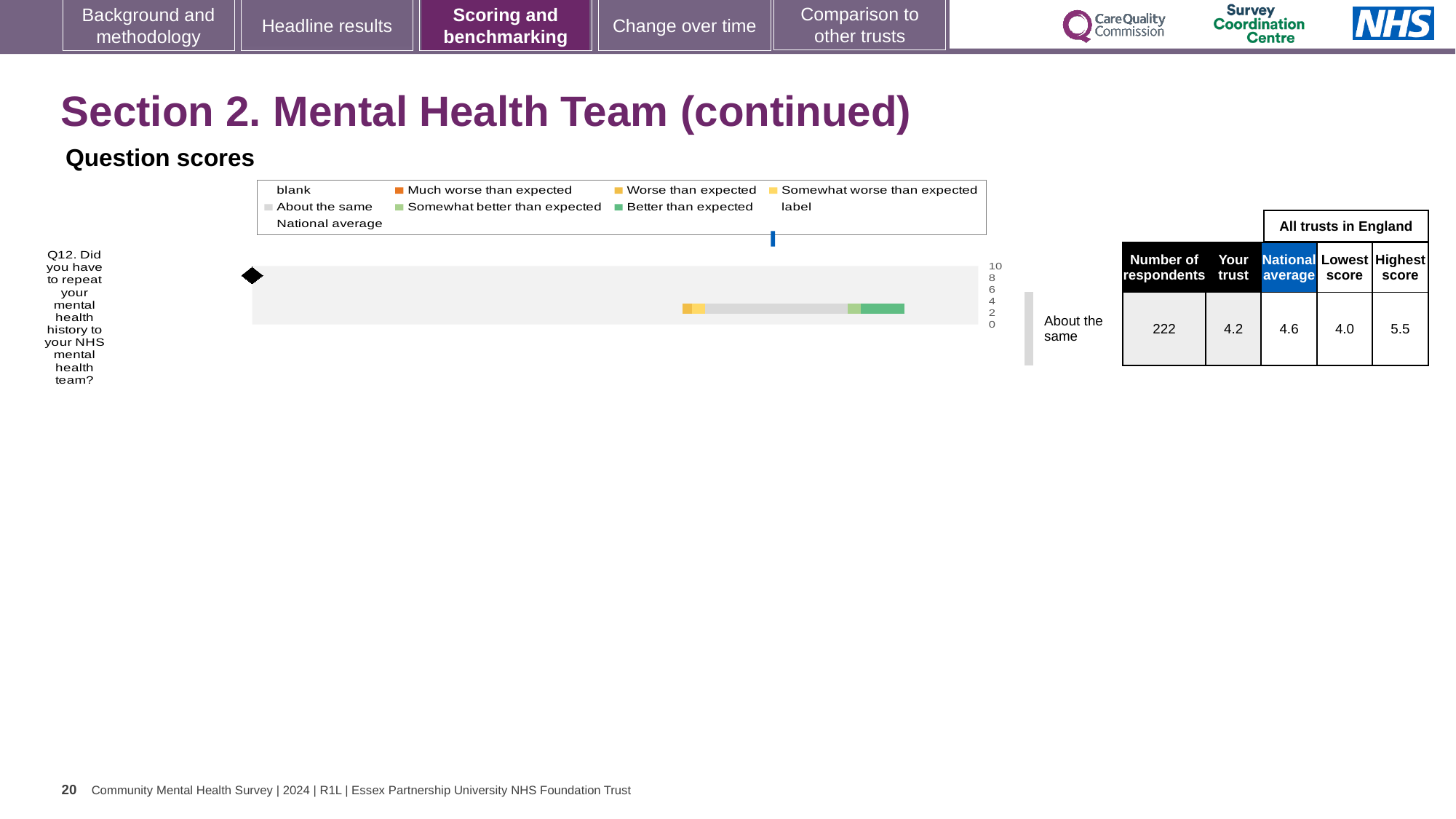
What is the highest score among all trusts in England for Q12? 5.5 What kind of chart is shown on the slide? bar chart What is the difference between the highest score and the lowest score for Q12? 1.5 Which survey question is plotted in the chart? Q12. Did you have to repeat your mental health history to your NHS mental health team? How many respondents answered Q12? 222 What is the difference between the national average and the 'Your trust' score for Q12? 0.4 What is the national average score for Q12? 4.6 What is the 'Your trust' score for Q12? 4.2 How many survey questions are plotted in the chart? 1 Which is larger for Q12, the 'Your trust' score or the national average? national average What benchmark category label is shown next to the bar for Q12? About the same What is the lowest score among all trusts in England for Q12? 4.0